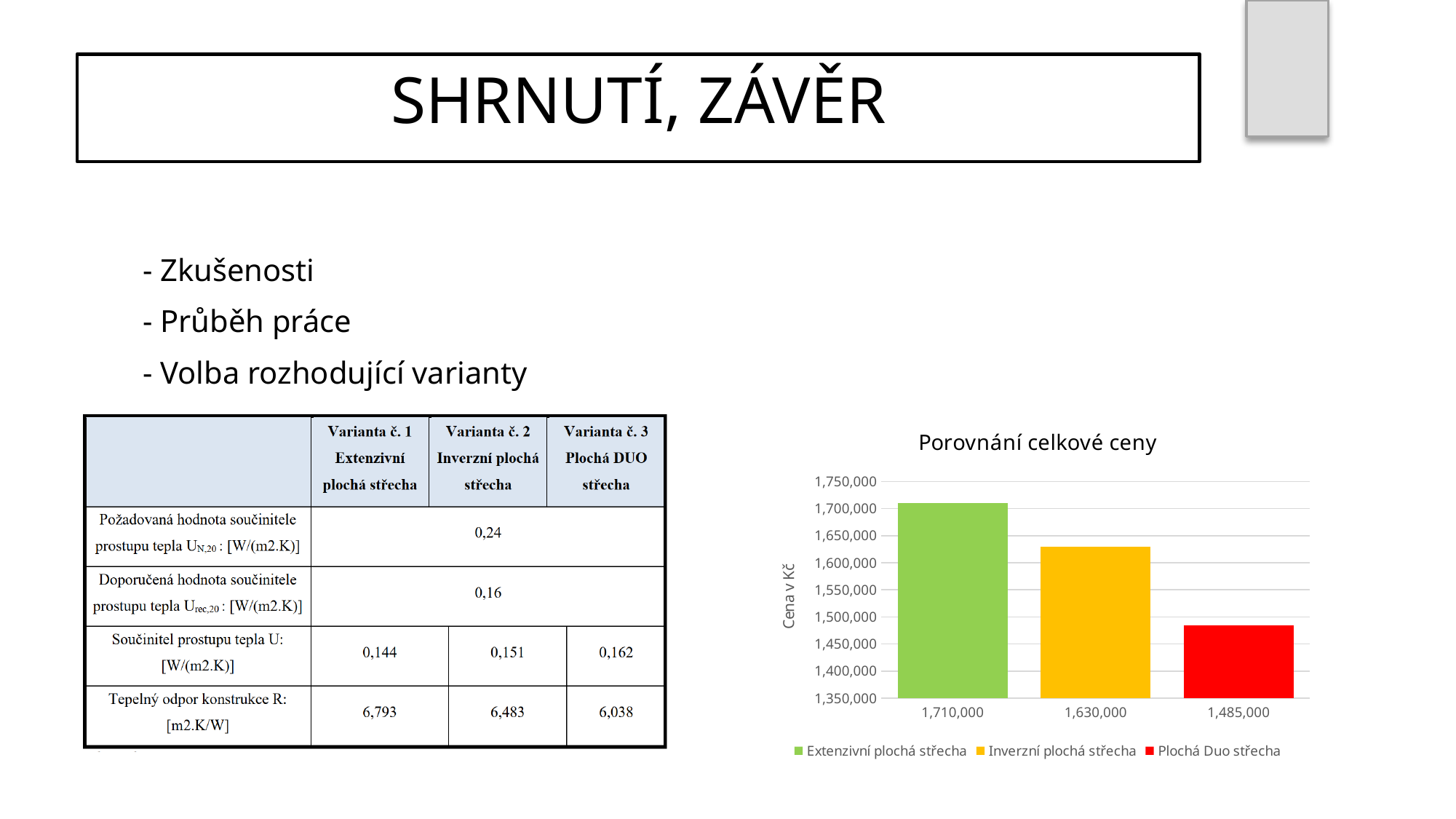
How many bars does the chart show? 3 Which roof variant has the highest total price in the chart? Extenzivní plochá střecha Is the value for Plochá Duo střecha greater or less than 1,500,000? less What is the value for Inverzní plochá střecha in the chart? 1,630,000 What is the value for Plochá Duo střecha in the chart? 1,485,000 What is the difference between the values for Extenzivní plochá střecha and Plochá Duo střecha? 225,000 Which is larger, the value for Inverzní plochá střecha or the value for Plochá Duo střecha? Inverzní plochá střecha Which roof variant has the lowest total price in the chart? Plochá Duo střecha What is the title of the chart on the slide? Porovnání celkové ceny What is the value for Extenzivní plochá střecha in the chart? 1,710,000 What kind of chart is shown on the slide? bar chart How many entries does the chart legend list? 3